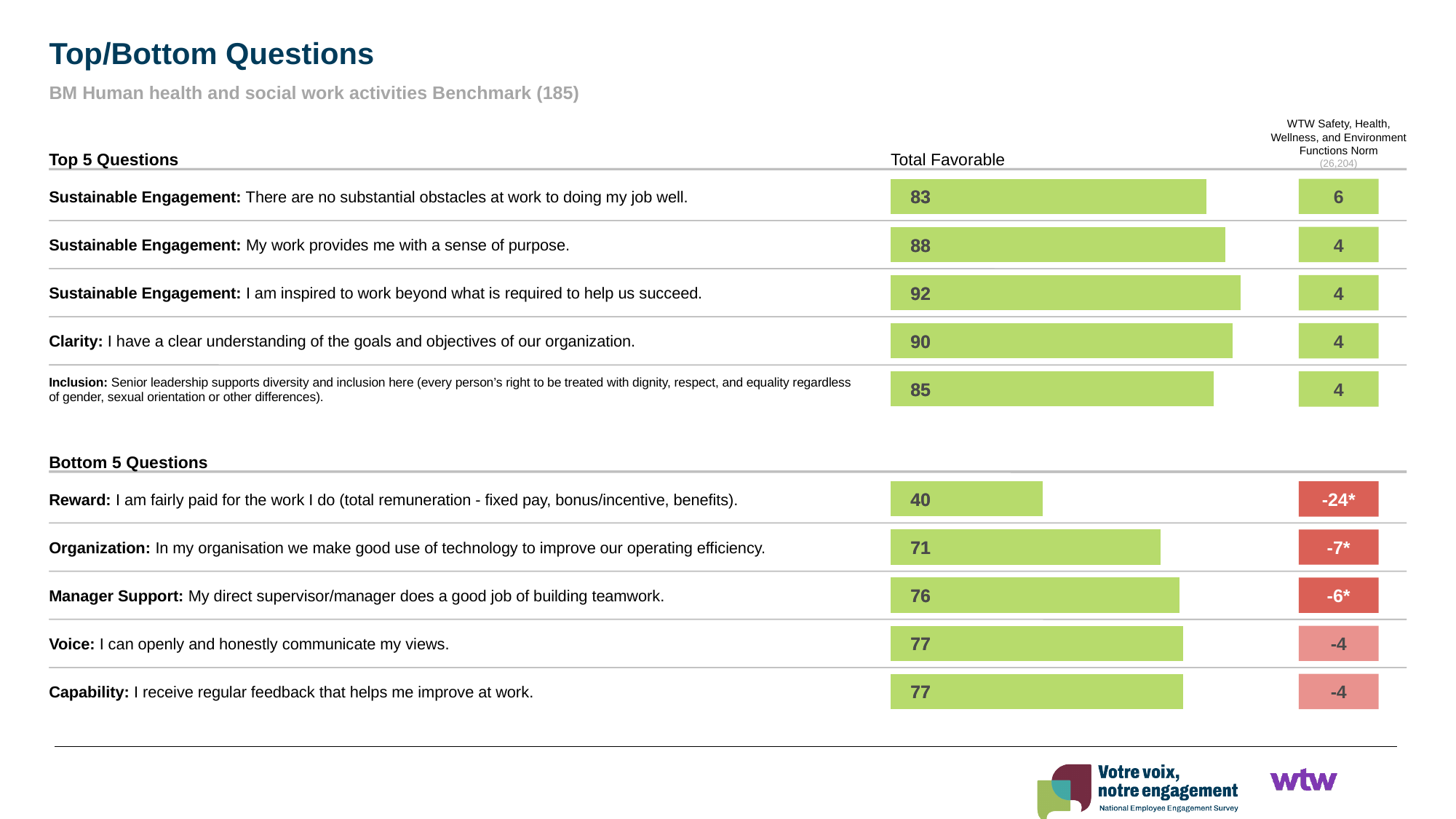
In the Top 5 Questions chart, which question has the highest Total Favorable value? Sustainable Engagement: I am inspired to work beyond what is required to help us succeed. In the Top 5 Questions chart, what is the Total Favorable value for "Clarity: I have a clear understanding of the goals and objectives of our organization"? 90 What kind of chart is used to show the Total Favorable values on this slide? Bar chart In the Top 5 Questions chart, what is the WTW Safety, Health, Wellness, and Environment Functions Norm difference for "There are no substantial obstacles at work to doing my job well"? 6 In the Bottom 5 Questions chart, what is the difference in Total Favorable between "Voice: I can openly and honestly communicate my views" and "Reward: I am fairly paid for the work I do"? 37 How many questions are listed in the Bottom 5 Questions chart? 5 In the Bottom 5 Questions chart, which question has the lowest Total Favorable value? Reward: I am fairly paid for the work I do (total remuneration - fixed pay, bonus/incentive, benefits). In the Bottom 5 Questions chart, what is the Total Favorable value for "Reward: I am fairly paid for the work I do"? 40 In the Bottom 5 Questions chart, which has a larger Total Favorable value: "Manager Support: My direct supervisor/manager does a good job of building teamwork" or "Organization: In my organisation we make good use of technology to improve our operating efficiency"? Manager Support: My direct supervisor/manager does a good job of building teamwork. In the Bottom 5 Questions chart, what is the norm difference shown for "Organization: In my organisation we make good use of technology to improve our operating efficiency"? -7* In the Top 5 Questions chart, which question has the lowest Total Favorable value? Sustainable Engagement: There are no substantial obstacles at work to doing my job well. In the Top 5 Questions chart, what is the difference in Total Favorable between "I am inspired to work beyond what is required to help us succeed" and "There are no substantial obstacles at work to doing my job well"? 9